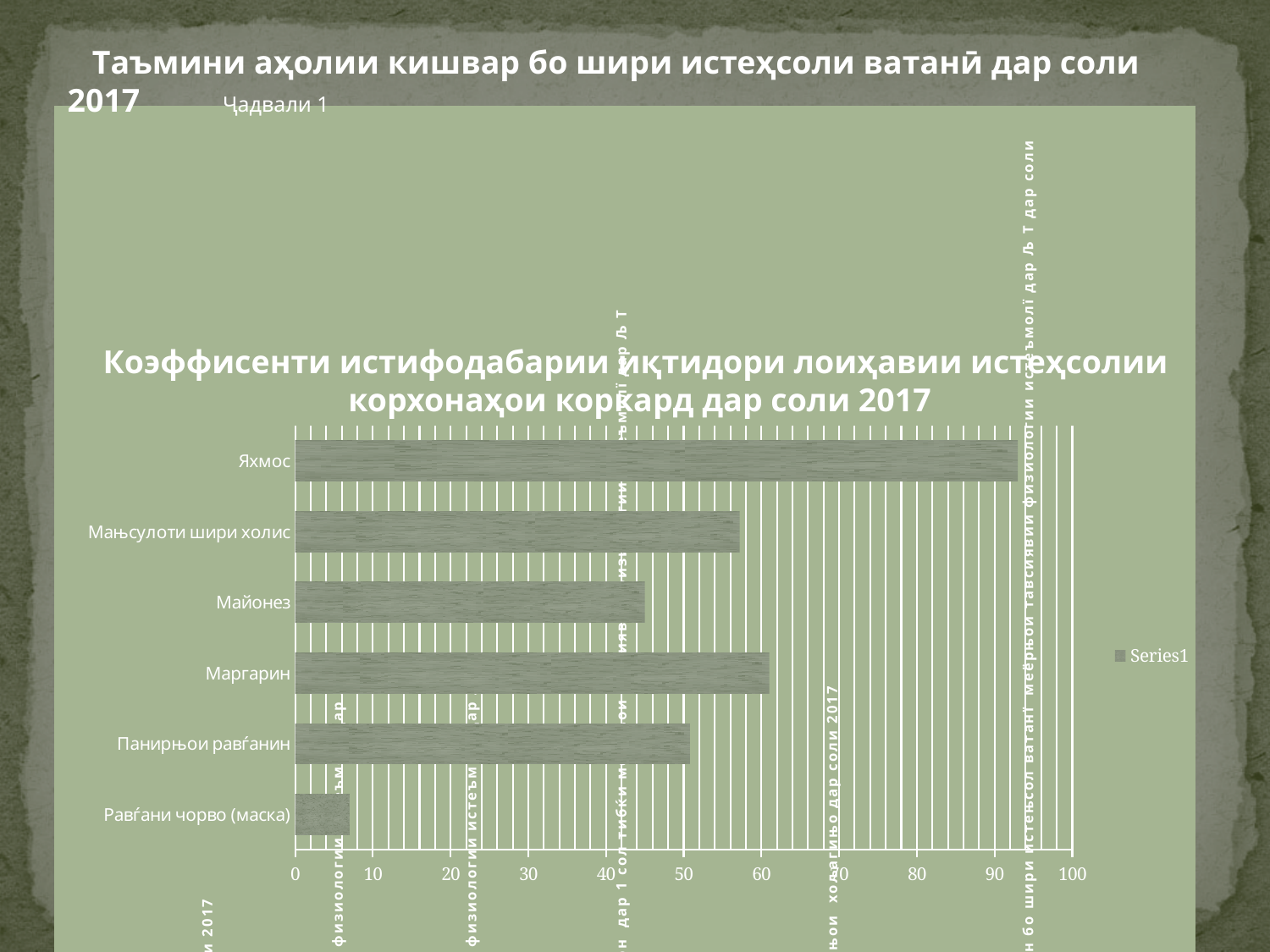
Is the value for Майонез greater or less than 50? less Which category has the lowest value in the chart? Равғани чорво (маска) Is the value for Равғани чорво (маска) greater or less than 10? less What kind of chart is shown on the slide? bar chart Which is larger, the value for Маргарин or the value for Панирҳои равғанин? Маргарин Is the value for Яхмос greater or less than 90? greater How many series does the legend list? 1 Which is larger, the value for Майонез or the value for Панирҳои равғанин? Панирҳои равғанин Which category has the highest value in the chart? Яхмос What is the name of the series shown in the chart legend? Series1 How many categories are plotted in the chart? 6